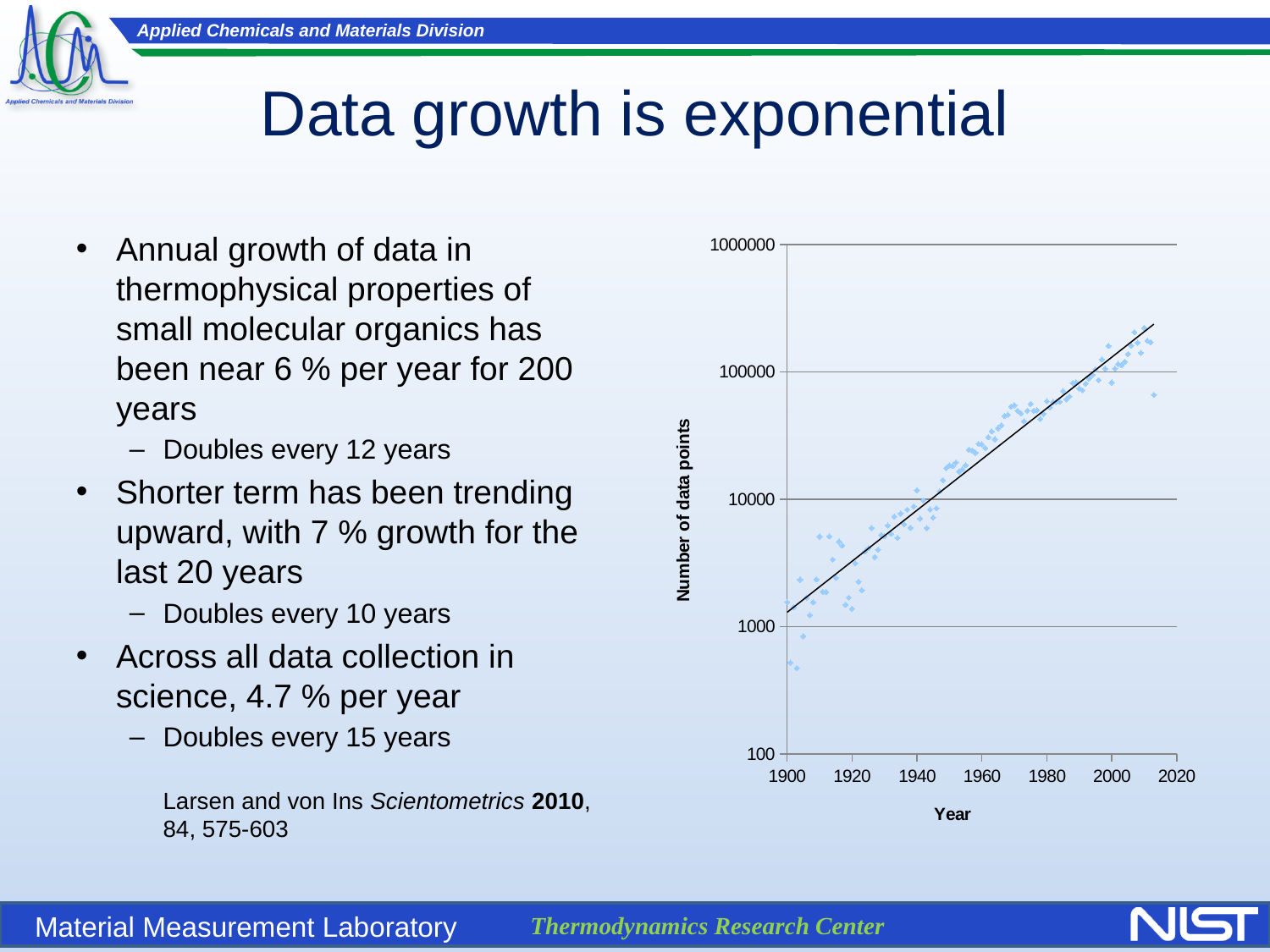
Are the plotted values for years around 1900 greater or less than 10000? less Do the plotted values rise or fall as the year increases along the x axis? rise What is the label of the x axis of the chart? Year Are the plotted values for years around 1960 greater or less than 100000? less What is the label of the y axis of the chart? Number of data points Are the plotted values for years around 1920 greater or less than 1000? greater What kind of chart is shown on the right of the slide? scatter chart Which period has larger plotted values, around 1940 or around 2000? around 2000 What is the highest tick value shown on the y axis of the chart? 1000000